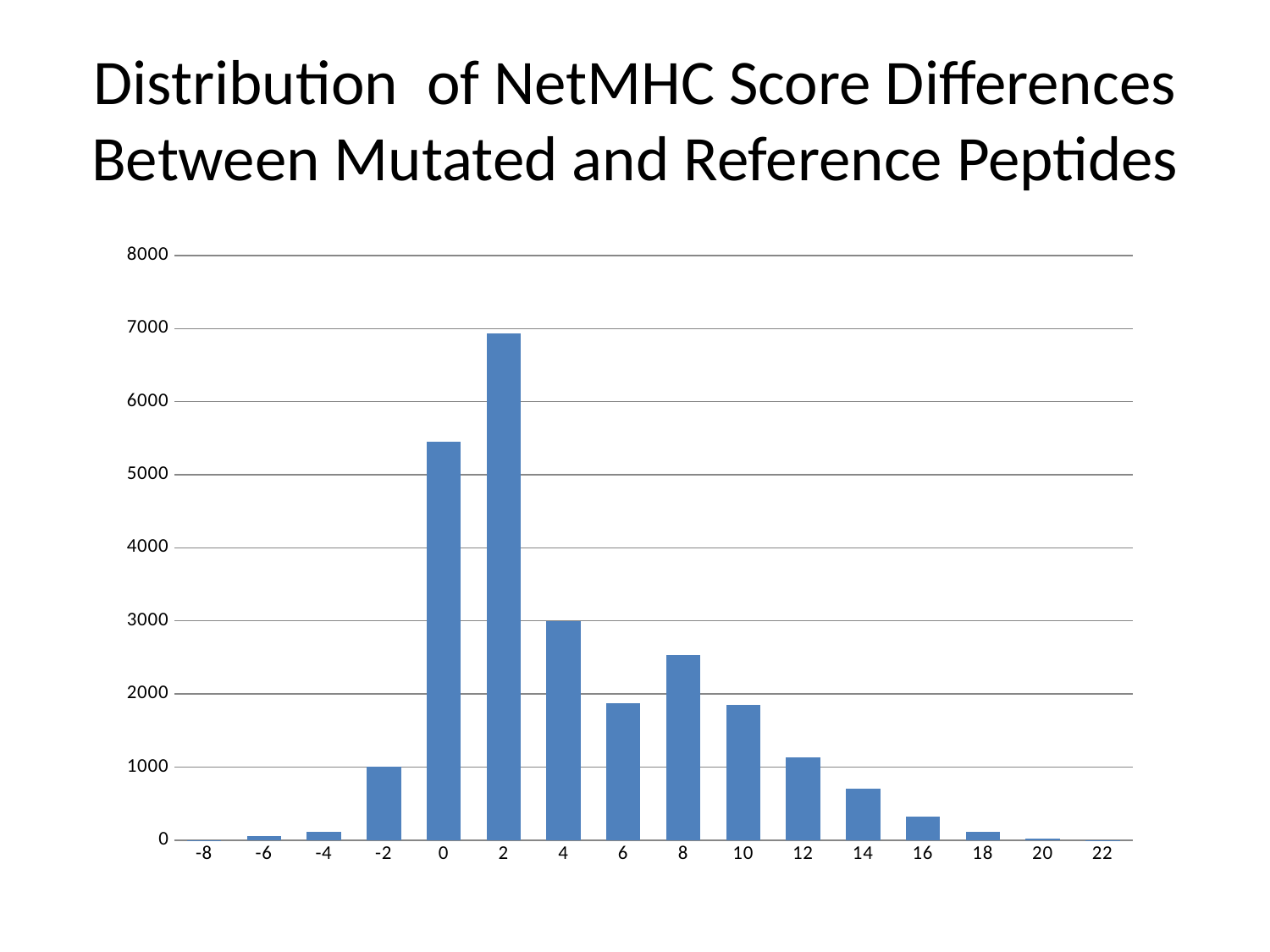
What kind of chart is shown on the slide? bar chart Is the value for category 8 greater or less than 2000? greater Is the value for category 0 greater or less than 5000? greater Which is larger, the value for category 0 or the value for category 4? 0 Do the values rise or fall from category 2 to category 16? fall Which category has the highest bar? 2 Is the value for category 14 greater or less than 1000? less Which is larger, the value for category 8 or the value for category 10? 8 How many categories are shown along the x axis? 16 What is the title of the chart? Distribution of NetMHC Score Differences Between Mutated and Reference Peptides